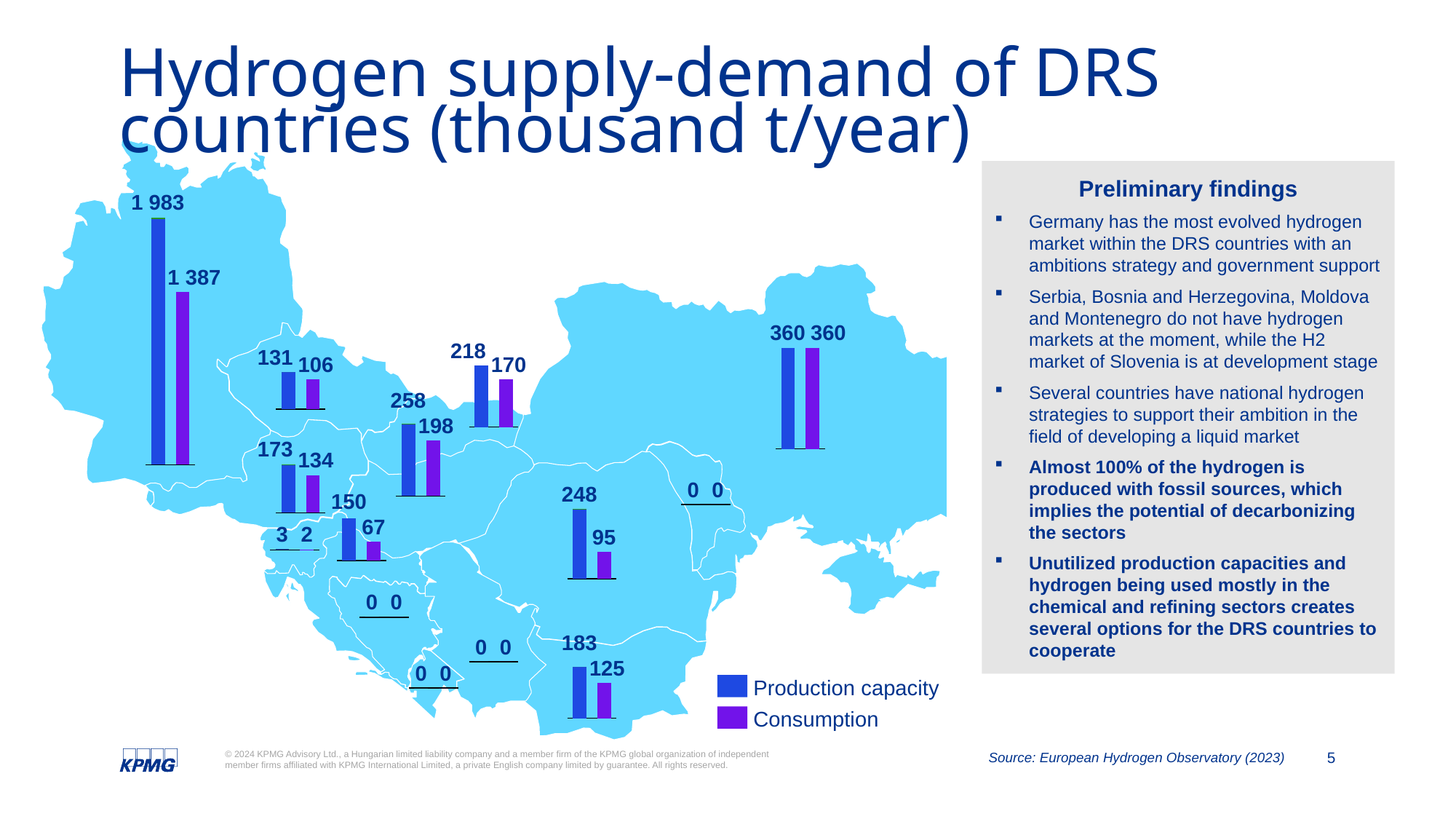
What is the consumption value paired with the production capacity of 218? 170 How many countries on the map show 0 for both production capacity and consumption? 4 What is the consumption value paired with the production capacity of 150? 67 What are the two series named in the legend? Production capacity and Consumption For the country showing 360 and 360, which is larger, production capacity or consumption? They are equal What is the consumption value shown next to the production capacity of 1 983? 1 387 How many series does the legend list? 2 What is the difference between the production capacity of 1 983 and its paired consumption of 1 387? 596 What is the difference between the production capacity of 248 and its paired consumption of 95? 153 What is the consumption value paired with the production capacity of 248? 95 What kind of chart is used on the map to show each country's values? bar chart What is the highest production capacity value shown on the map? 1 983